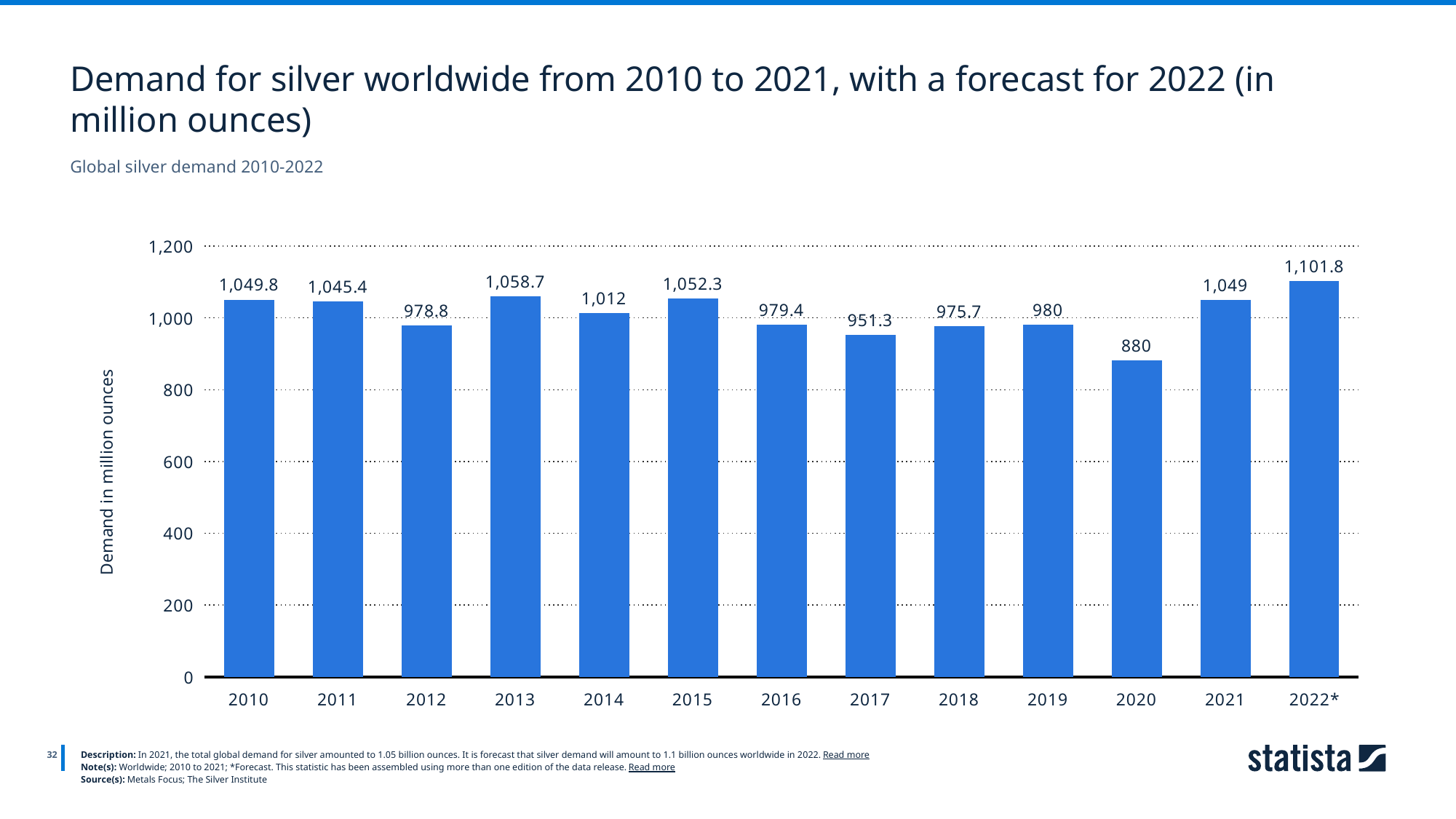
What kind of chart is shown on the slide? bar chart What is the label of the y axis? Demand in million ounces What was the demand for silver in 2020? 880 Is the value for 2012 greater or less than 1,000? less Which year has the lowest silver demand on the chart? 2020 Which year had higher silver demand, 2017 or 2019? 2019 What is the forecast silver demand for 2022*? 1,101.8 What is the difference between the silver demand in 2021 and in 2020? 169 Which year has the highest silver demand on the chart? 2022* How many years are shown on the x axis of the chart? 13 What was the demand for silver worldwide in 2013? 1,058.7 Did silver demand rise or fall from 2019 to 2020? fall